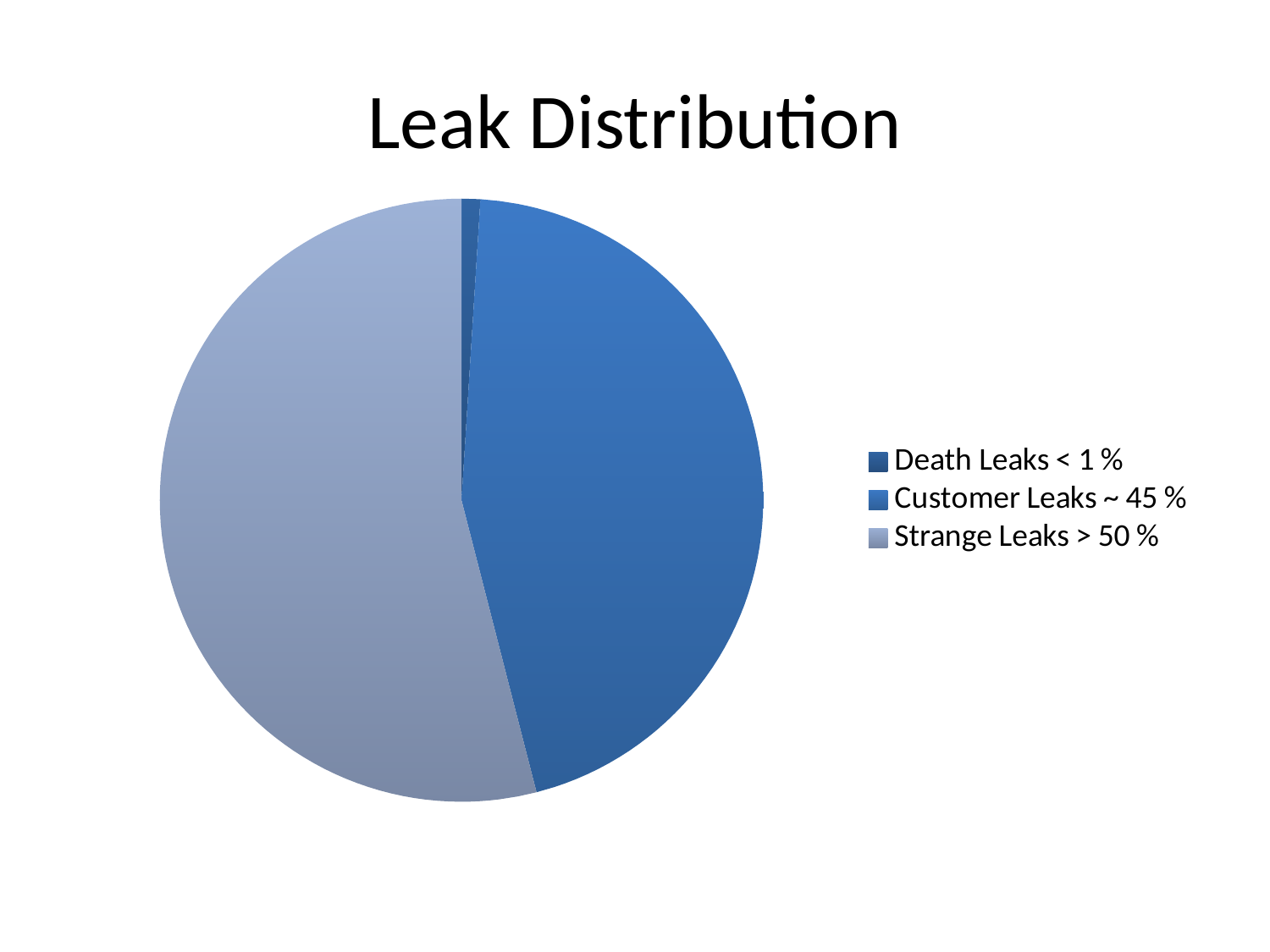
Which category has the smallest slice of the pie? Death Leaks < 1 % What is the title of the chart? Leak Distribution Which category has the largest slice of the pie? Strange Leaks > 50 % Which slice is larger, Death Leaks or Customer Leaks? Customer Leaks What kind of chart is shown on the slide? pie chart How many entries does the legend list? 3 Which slice is larger, Customer Leaks or Strange Leaks? Strange Leaks What is the full legend label for the lightest-coloured slice? Strange Leaks > 50 % How many slices does the pie chart have? 3